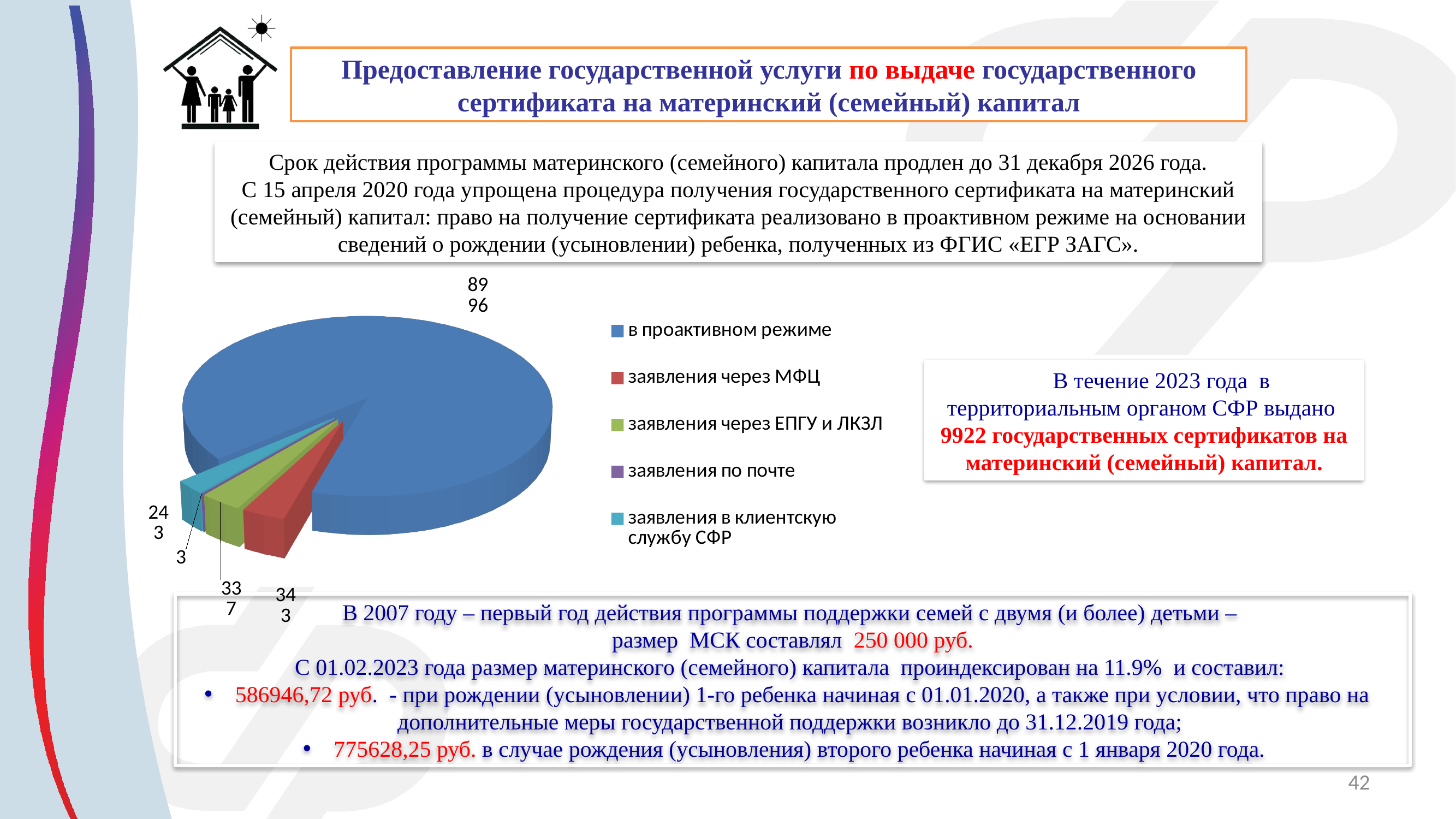
Which category has the largest slice in the pie chart? в проактивном режиме Which category has the smallest slice in the pie chart? заявления по почте What is the difference between the values for 'в проактивном режиме' and 'заявления по почте'? 8993 What is the total of all slices in the pie chart? 9922 What is the value shown for 'заявления в клиентскую службу СФР' in the pie chart? 243 What is the value shown for 'заявления по почте' in the pie chart? 3 How many slices does the pie chart have? 5 What is the value shown for 'в проактивном режиме' in the pie chart? 8996 What colour is the slice for 'заявления через ЕПГУ и ЛКЗЛ' in the pie chart? green How many categories does the legend of the pie chart list? 5 What kind of chart is shown on the slide? pie chart Which is larger in the pie chart: 'в проактивном режиме' or 'заявления через МФЦ'? в проактивном режиме